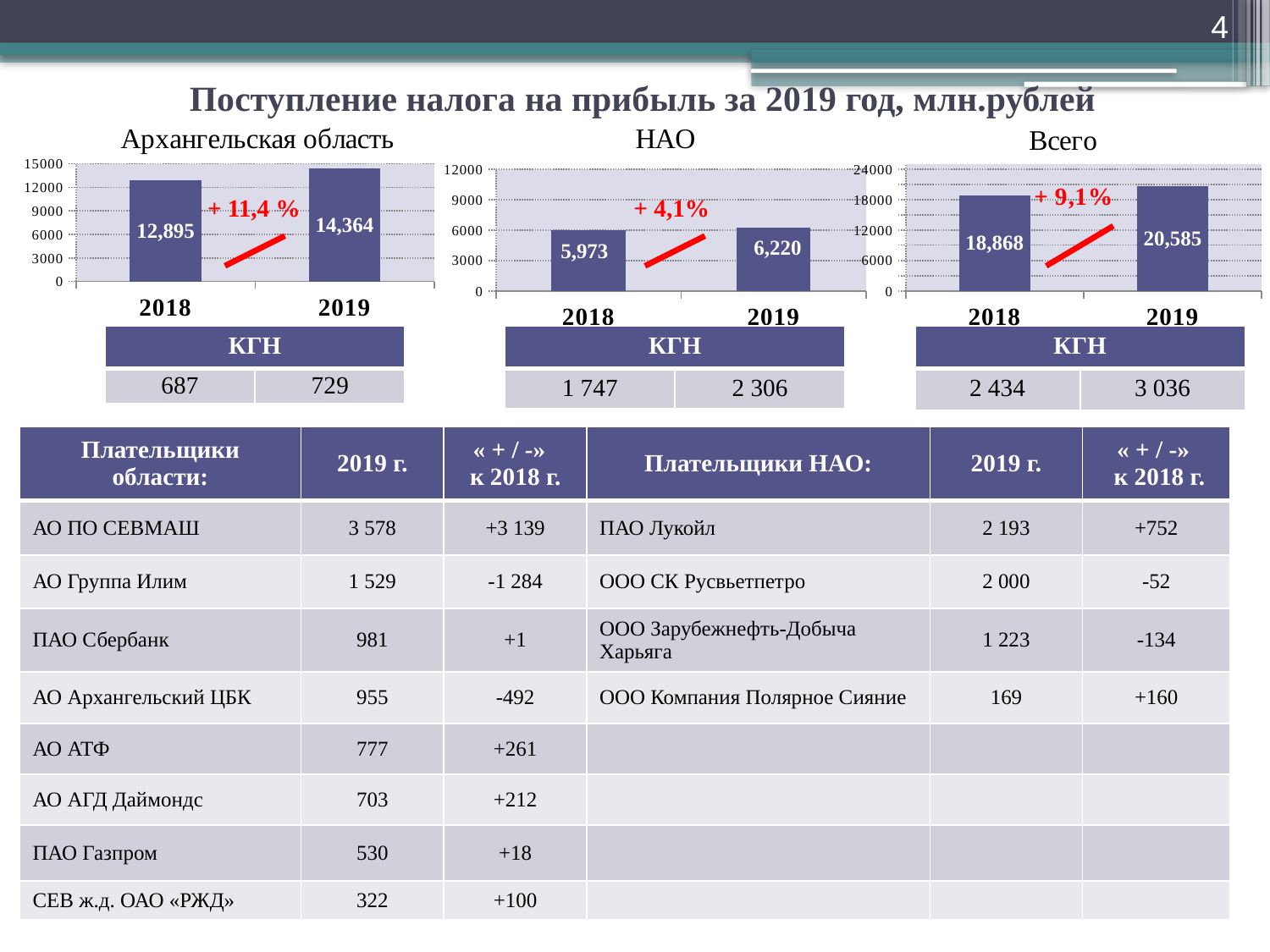
In the Архангельская область chart, what is the value for 2019? 14,364 What type of chart is the Всего chart? bar chart In the Всего chart, what is the value for 2018? 18,868 In the НАО chart, what is the value for 2019? 6,220 What percentage change is annotated on the Всего chart? + 9,1% In the НАО chart, what is the value for 2018? 5,973 In the Архангельская область chart, what is the value for 2018? 12,895 In the Архангельская область chart, what is the difference between the 2019 and 2018 values? 1,469 In the Всего chart, which year has the higher value? 2019 In the НАО chart, what is the difference between the 2019 and 2018 values? 247 In the Всего chart, what is the value for 2019? 20,585 In the НАО chart, do the values rise or fall from 2018 to 2019? rise